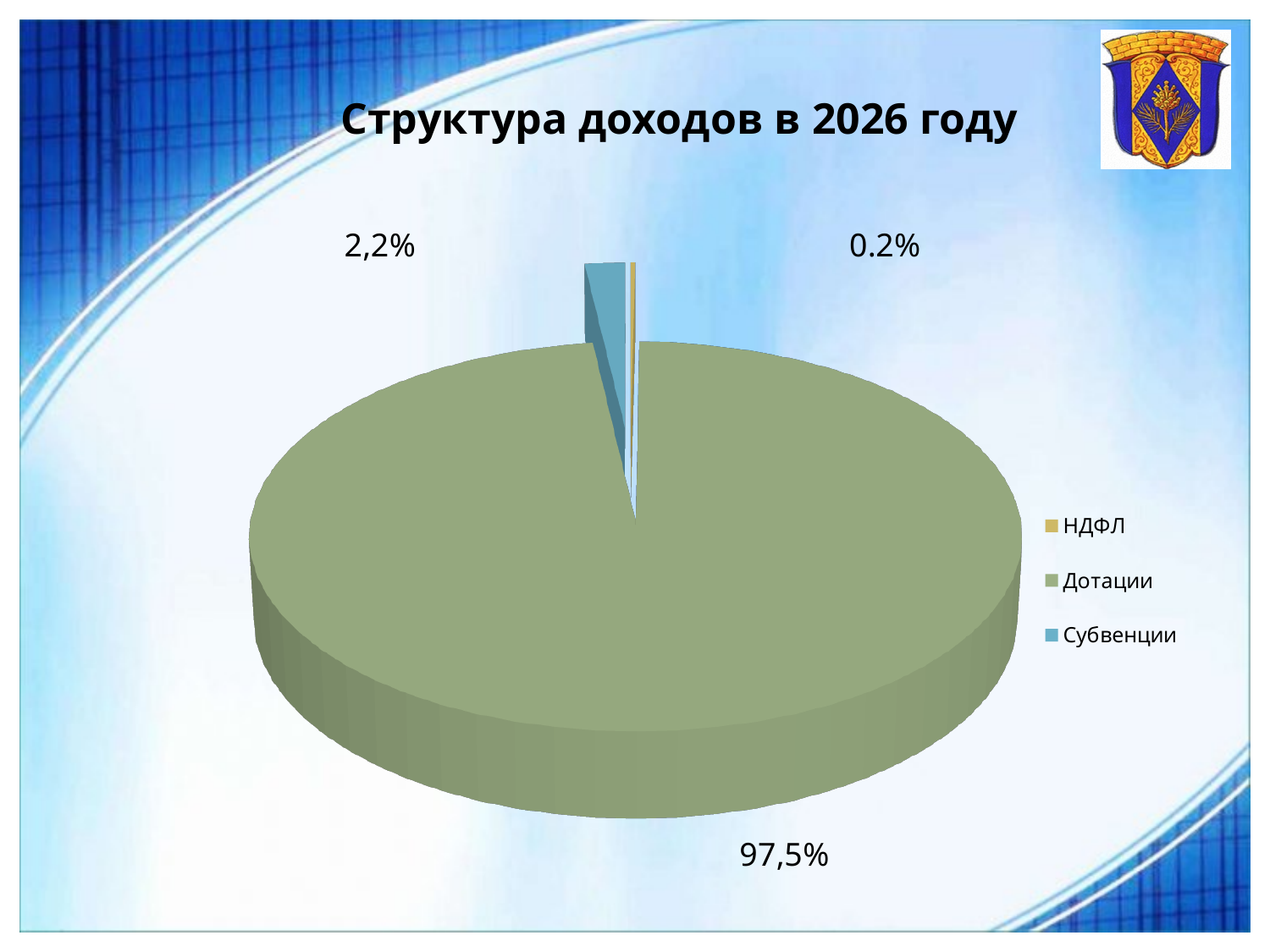
What is the difference between the shares of Дотации and Субвенции? 95,3% Which category has the largest slice of the pie? Дотации Which is larger, the slice for Субвенции or the slice for НДФЛ? Субвенции What colour is the slice for Субвенции? blue Which category has the smallest slice of the pie? НДФЛ What share of the pie does Дотации have? 97,5% What share of the pie does НДФЛ have? 0.2% How many categories does the legend list? 3 What share of the pie does Субвенции have? 2,2% What kind of chart is shown on the slide? pie chart What is the title of the chart? Структура доходов в 2026 году